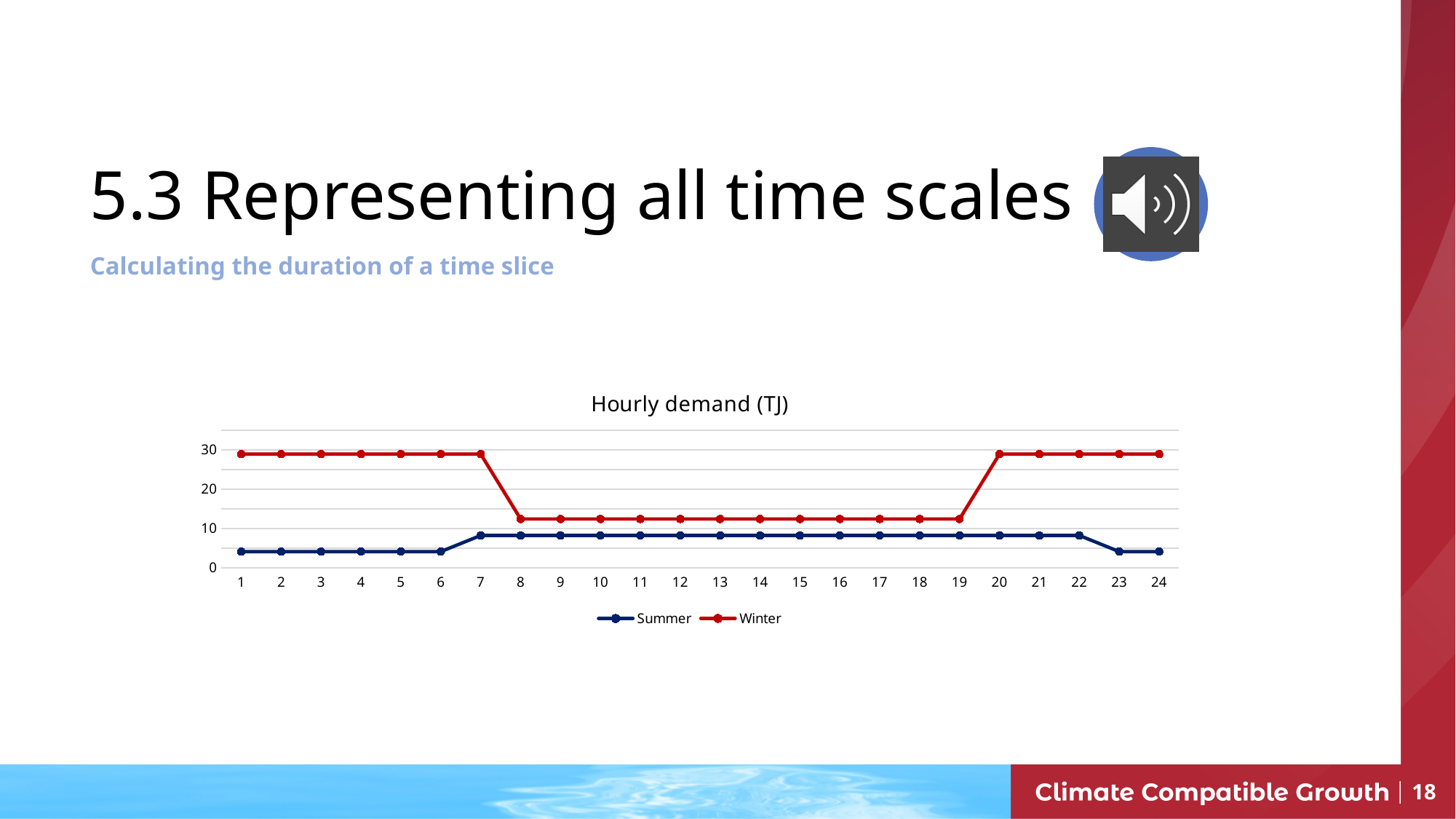
Is the Summer value at hour 10 greater or less than 10? less What kind of chart is shown on the slide? line chart At hour 15, which series has the larger value, Summer or Winter? Winter Does the Winter series rise or fall between hour 7 and hour 8? fall Is the Summer value at hour 2 greater or less than 10? less What is the title of the chart? Hourly demand (TJ) How many series does the legend list? 2 Is the Winter value at hour 12 greater or less than 20? less Which series is drawn in red? Winter Does the Summer series rise or fall between hour 6 and hour 7? rise How many hours are plotted along the x axis? 24